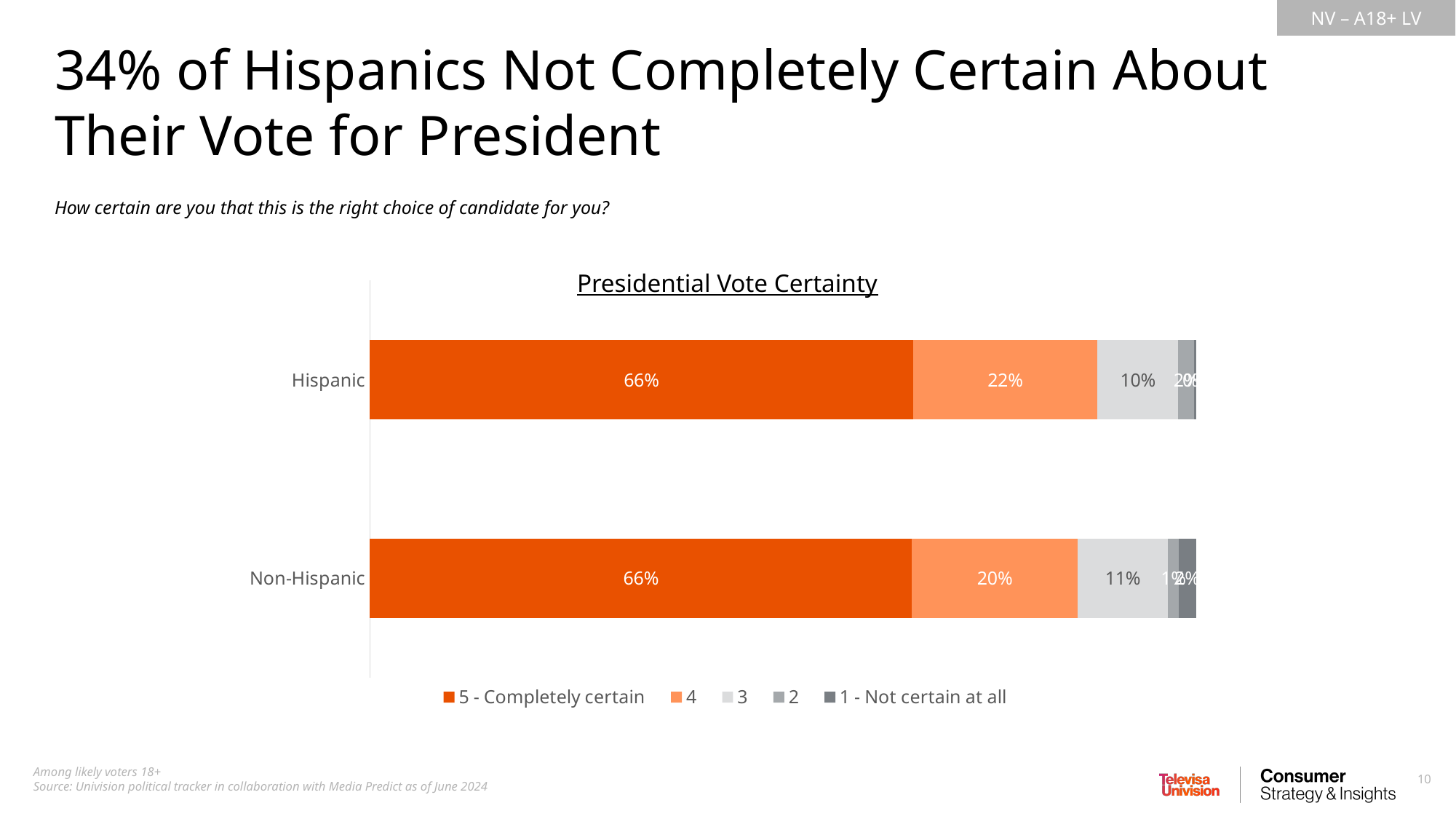
What is the value of the '3' segment for Non-Hispanic voters? 11% What is the value of the '4' segment for Non-Hispanic voters? 20% What is the title of the chart? Presidential Vote Certainty How many groups (categories) are shown on the chart? 2 What is the value of the '3' segment for Hispanic voters? 10% How many series does the legend list? 5 Which group has the larger '4' segment, Hispanic or Non-Hispanic? Hispanic What is the value of the '4' segment for Hispanic voters? 22% What percentage of Hispanic likely voters are '5 - Completely certain' about their vote for president? 66% What percentage of Non-Hispanic likely voters are '5 - Completely certain'? 66% What kind of chart is shown on the slide? Stacked bar chart What is the difference in percentage points between the '4' segment for Hispanic voters and for Non-Hispanic voters? 2 percentage points